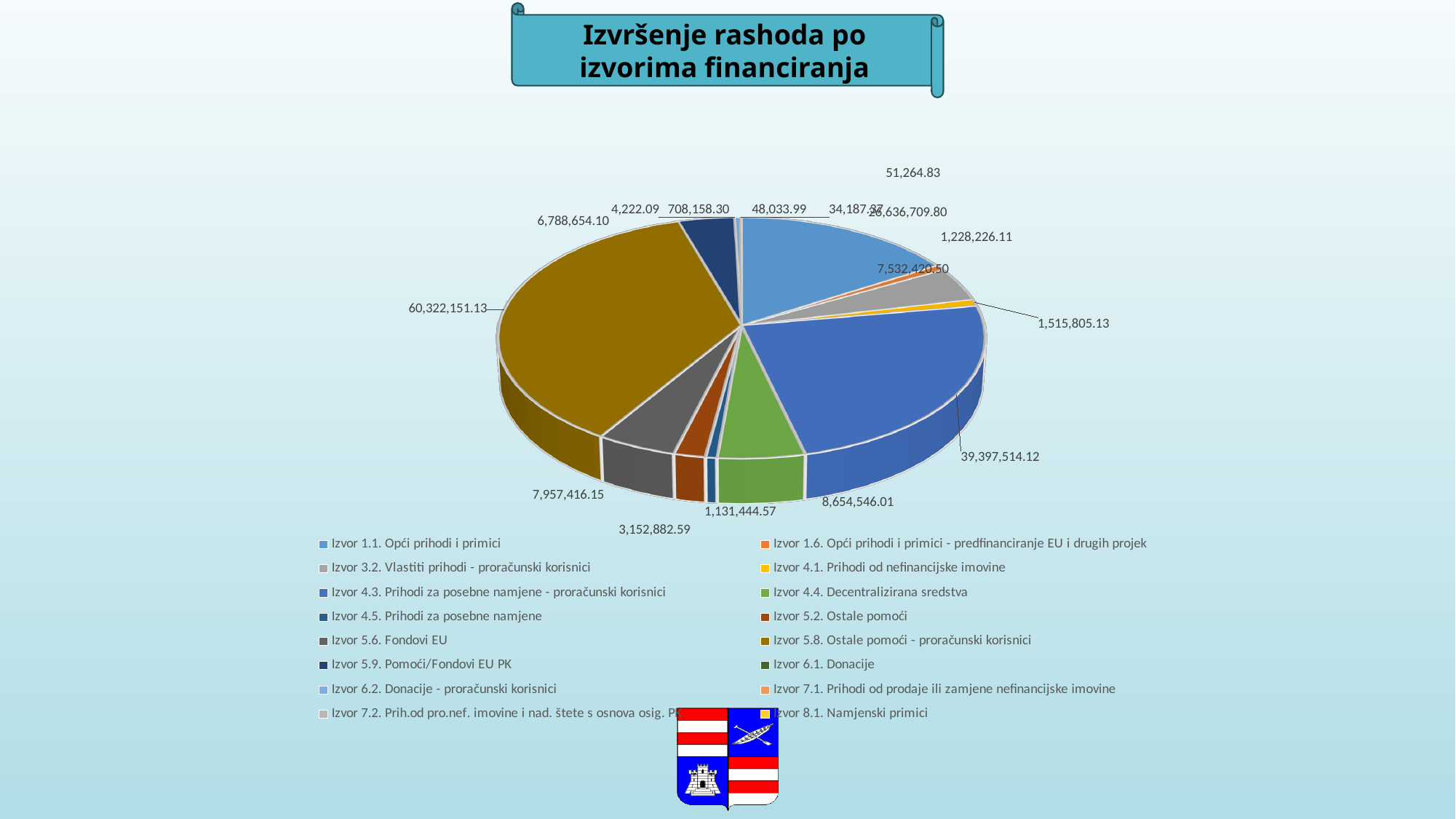
What is the value shown for Izvor 4.3. Prihodi za posebne namjene - proračunski korisnici? 39,397,514.12 Which is larger: the slice for Izvor 5.8. Ostale pomoći - proračunski korisnici or the slice for Izvor 4.3. Prihodi za posebne namjene - proračunski korisnici? Izvor 5.8. Ostale pomoći - proračunski korisnici Which is larger: the slice for Izvor 4.4. Decentralizirana sredstva or the slice for Izvor 1.1. Opći prihodi i primici? Izvor 1.1. Opći prihodi i primici What is the title of the chart on the slide? Izvršenje rashoda po izvorima financiranja Which source of financing has the largest slice in the pie chart? Izvor 5.8. Ostale pomoći - proračunski korisnici What kind of chart is shown on the slide? pie chart How many categories does the legend of the pie chart list? 16 What is the value shown for Izvor 1.1. Opći prihodi i primici? 26,636,709.80 What is the difference between the values for Izvor 5.8. Ostale pomoći - proračunski korisnici and Izvor 4.3. Prihodi za posebne namjene - proračunski korisnici? 20,924,637.01 What is the value shown for Izvor 4.4. Decentralizirana sredstva? 8,654,546.01 What is the value shown for Izvor 5.8. Ostale pomoći - proračunski korisnici? 60,322,151.13 What colour is the slice for Izvor 5.8. Ostale pomoći - proračunski korisnici? gold